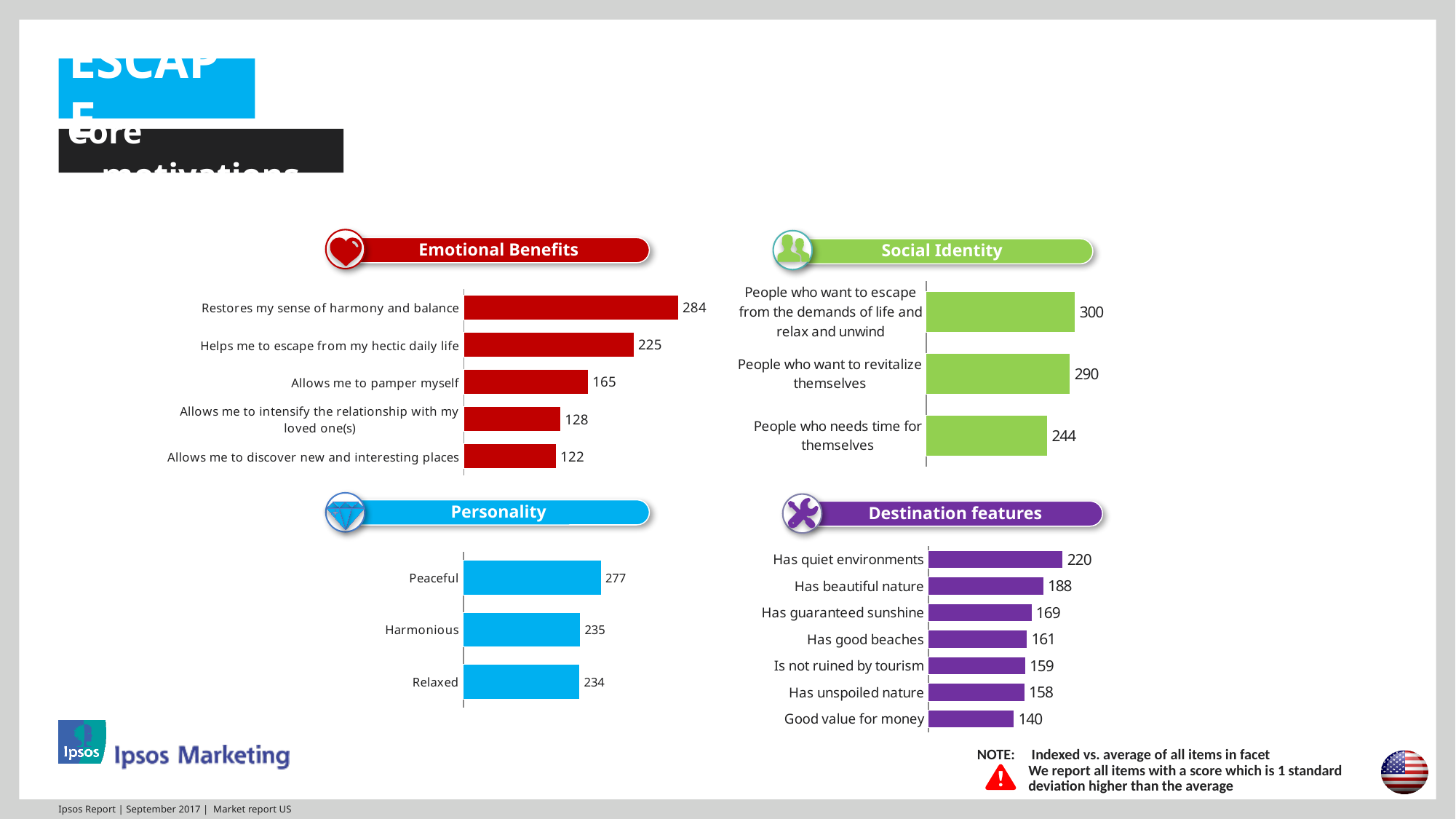
In the Emotional Benefits chart, which category has the highest value? Restores my sense of harmony and balance In the Social Identity chart, how many categories are shown? 3 What colour are the bars in the Social Identity chart? Green In the Personality chart, what is the value for "Peaceful"? 277 In the Destination features chart, which is larger: "Has beautiful nature" or "Has good beaches"? Has beautiful nature In the Social Identity chart, what is the value for "People who needs time for themselves"? 244 What kind of chart is the Destination features chart? Bar chart In the Personality chart, which category has the lowest value? Relaxed In the Emotional Benefits chart, what is the value for "Allows me to pamper myself"? 165 In the Emotional Benefits chart, what is the difference between "Restores my sense of harmony and balance" and "Helps me to escape from my hectic daily life"? 59 In the Destination features chart, how many categories are shown? 7 In the Destination features chart, which category has the lowest value? Good value for money